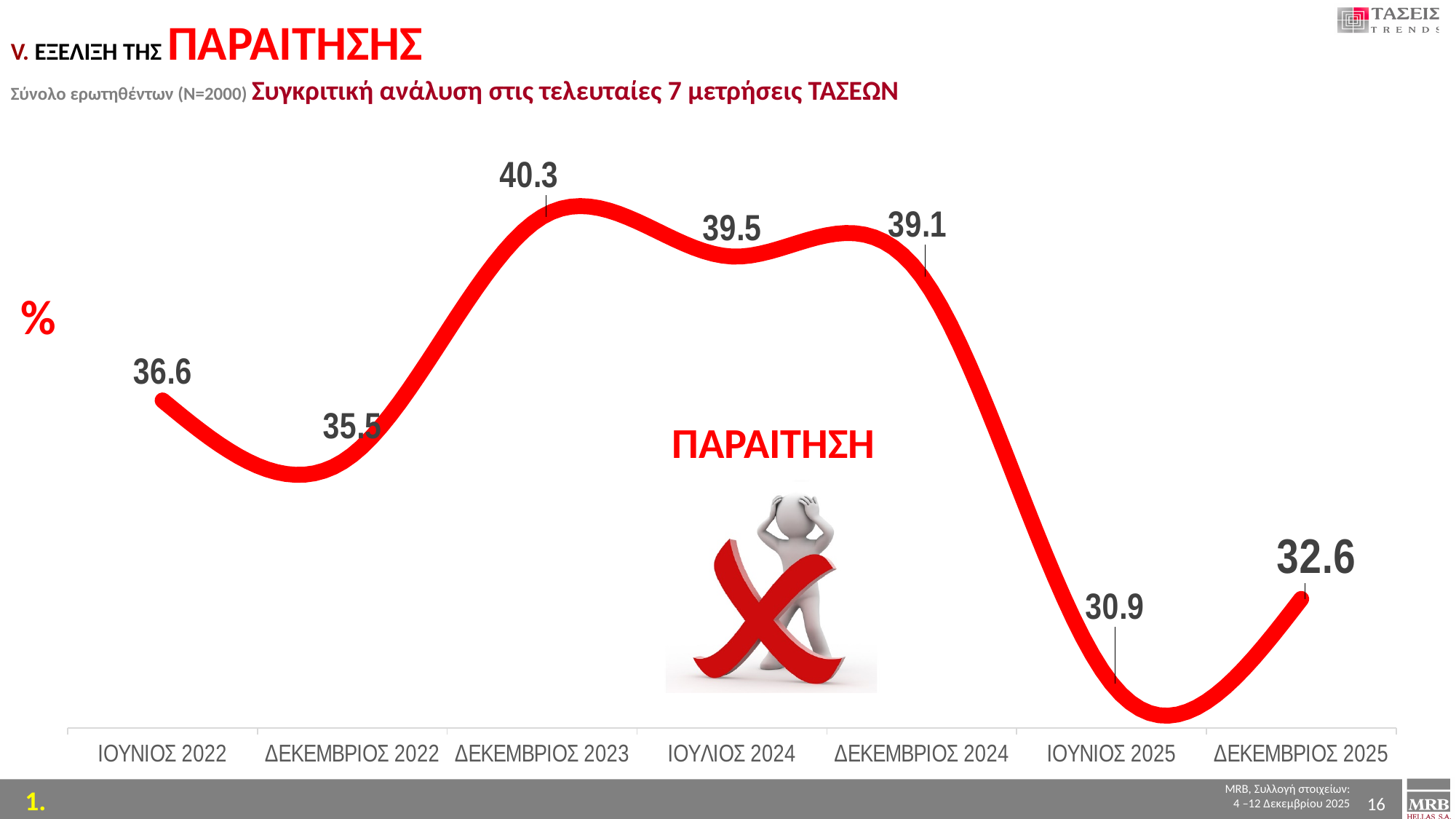
What is the value for ΙΟΥΝΙΟΣ 2022? 36.6 Which is larger, the value for ΔΕΚΕΜΒΡΙΟΣ 2024 or the value for ΔΕΚΕΜΒΡΙΟΣ 2025? ΔΕΚΕΜΒΡΙΟΣ 2024 Which measurement has the highest value? ΔΕΚΕΜΒΡΙΟΣ 2023 Does the value rise or fall from ΔΕΚΕΜΒΡΙΟΣ 2024 to ΙΟΥΝΙΟΣ 2025? fall What is the value for ΙΟΥΛΙΟΣ 2024? 39.5 Which measurement has the lowest value? ΙΟΥΝΙΟΣ 2025 What colour is the line on the chart? red What is the difference between the values for ΙΟΥΝΙΟΣ 2022 and ΔΕΚΕΜΒΡΙΟΣ 2022? 1.1 What is the value for ΔΕΚΕΜΒΡΙΟΣ 2025? 32.6 How many measurements are plotted on the chart? 7 What is the difference between the values for ΔΕΚΕΜΒΡΙΟΣ 2023 and ΙΟΥΝΙΟΣ 2025? 9.4 What kind of chart is shown on the slide? line chart